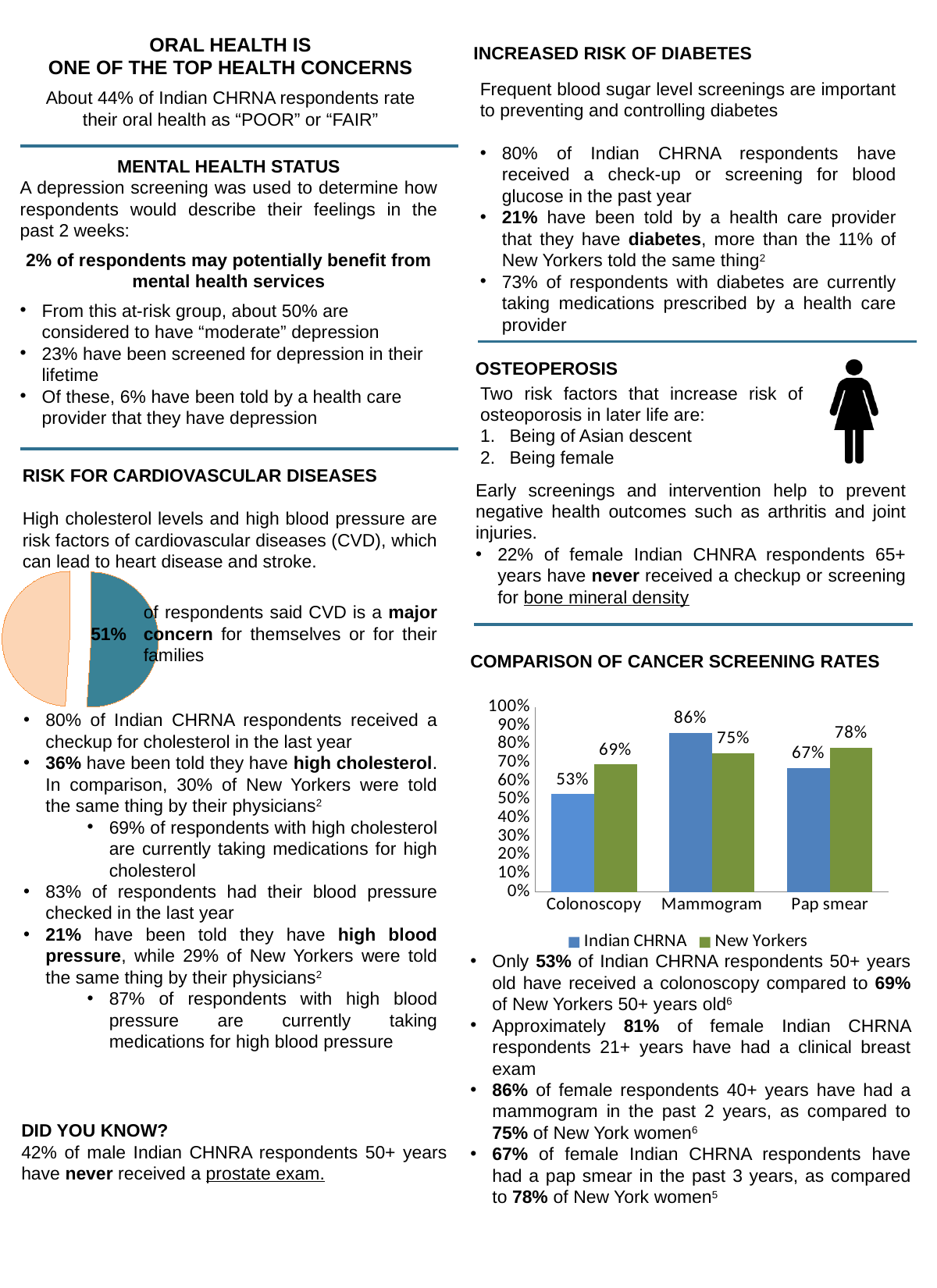
In the 'Comparison of Cancer Screening Rates' chart, what is the value for New Yorkers for Mammogram? 75% In the 'Comparison of Cancer Screening Rates' chart, what is the value for New Yorkers for Pap smear? 78% What kind of chart is the 'Comparison of Cancer Screening Rates' chart? bar chart In the 'Comparison of Cancer Screening Rates' chart, which category has the lowest value for New Yorkers? Colonoscopy How many categories are shown on the x axis of the 'Comparison of Cancer Screening Rates' chart? 3 In the 'Comparison of Cancer Screening Rates' chart, what is the difference between the New Yorkers and Indian CHRNA values for Colonoscopy? 16% How many series does the legend of the 'Comparison of Cancer Screening Rates' chart list? 2 In the 'Comparison of Cancer Screening Rates' chart, which is larger for Mammogram: Indian CHRNA or New Yorkers? Indian CHRNA In the 'Comparison of Cancer Screening Rates' chart, which category has the highest value for Indian CHRNA? Mammogram In the 'Comparison of Cancer Screening Rates' chart, what is the value for Indian CHRNA for Colonoscopy? 53% In the 'Comparison of Cancer Screening Rates' chart, is the Indian CHRNA value for Pap smear greater or less than 80%? less In the pie chart in the 'Risk for Cardiovascular Diseases' section, what share is shown for the labeled slice? 51%